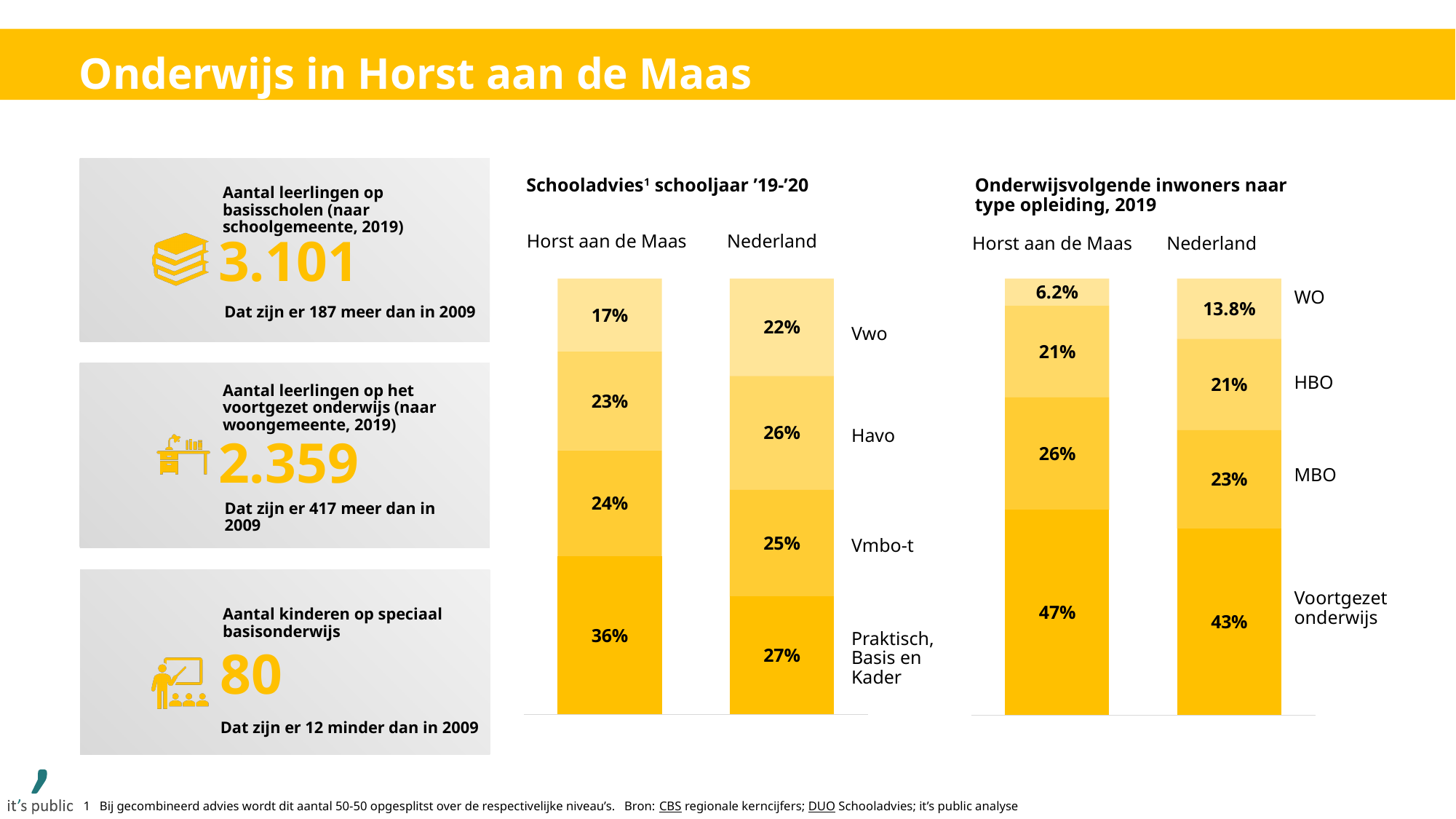
In the 'Onderwijsvolgende inwoners naar type opleiding, 2019' chart, what is the difference between the WO share of Nederland and that of Horst aan de Maas? 7.6 percentage points What type of chart is used for 'Onderwijsvolgende inwoners naar type opleiding, 2019'? Stacked bar chart In the 'Schooladvies schooljaar '19-'20' chart, what is the Praktisch, Basis en Kader share for Nederland? 27% In the 'Schooladvies schooljaar '19-'20' chart, what percentage of Horst aan de Maas pupils received a Vwo advice? 17% In the 'Schooladvies schooljaar '19-'20' chart, how much higher is the Praktisch, Basis en Kader share in Horst aan de Maas than in Nederland? 9 percentage points In the 'Onderwijsvolgende inwoners naar type opleiding, 2019' chart, which has the larger Voortgezet onderwijs share, Horst aan de Maas or Nederland? Horst aan de Maas In the 'Onderwijsvolgende inwoners naar type opleiding, 2019' chart, which type of education has the smallest share for Horst aan de Maas? WO In the 'Schooladvies schooljaar '19-'20' chart, how many advice levels are shown in each stacked bar? 4 In the 'Onderwijsvolgende inwoners naar type opleiding, 2019' chart, what is the MBO share for Nederland? 23% In the 'Onderwijsvolgende inwoners naar type opleiding, 2019' chart, what is the WO share for Horst aan de Maas? 6.2% In the 'Schooladvies schooljaar '19-'20' chart, which advice level has the largest share for Horst aan de Maas? Praktisch, Basis en Kader In the 'Schooladvies schooljaar '19-'20' chart, which has the larger Havo share, Horst aan de Maas or Nederland? Nederland